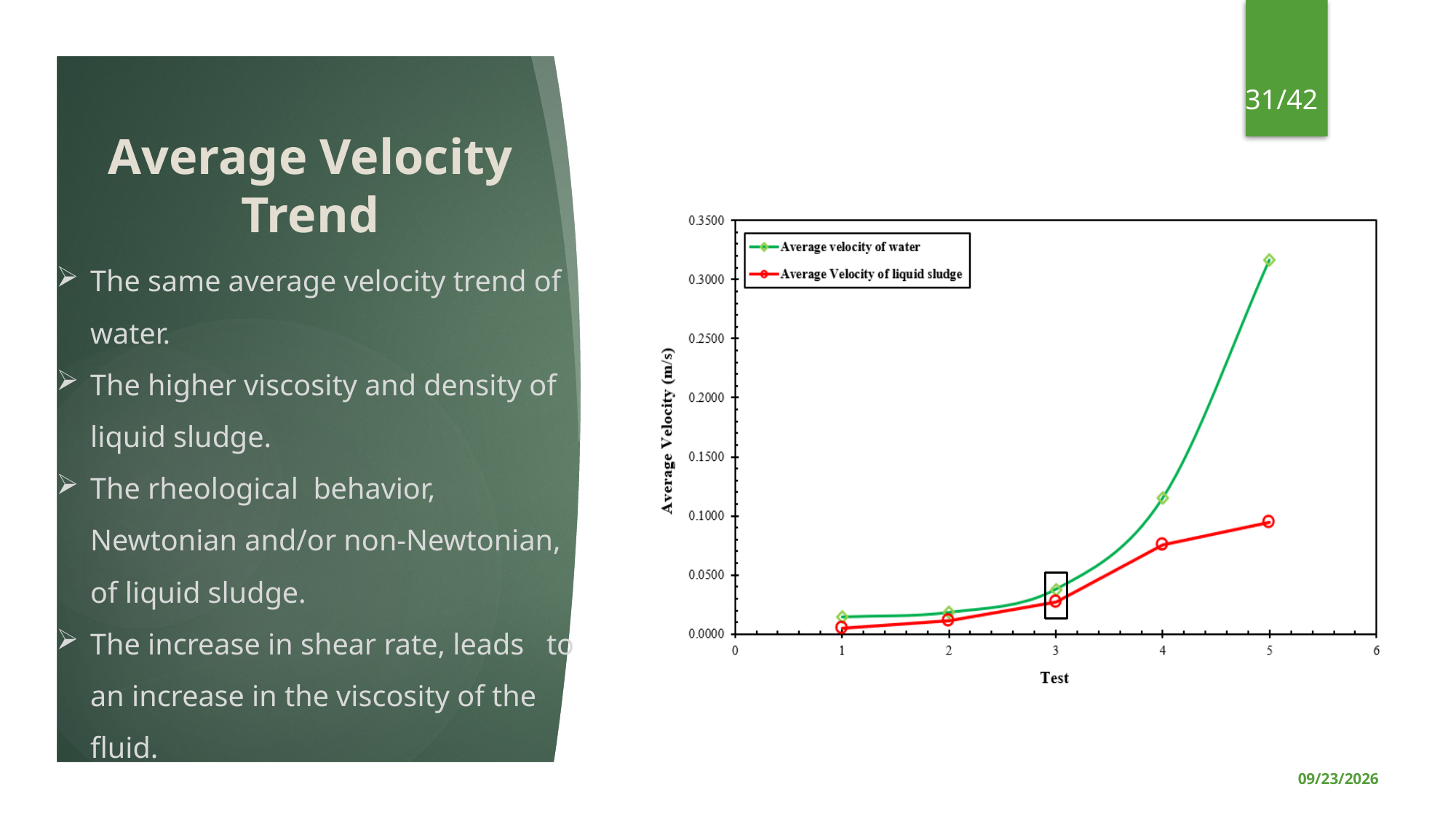
Is the average velocity of liquid sludge at test 4 greater or less than 0.1000 m/s? less Which colour is used for the average velocity of liquid sludge series? Red Is the average velocity of water at test 5 greater or less than 0.3000 m/s? greater What is the label of the y axis? Average Velocity (m/s) At which test is the average velocity of liquid sludge lowest? Test 1 Which series has the larger value at test 5, average velocity of water or average velocity of liquid sludge? Average velocity of water At which test is the average velocity of water highest? Test 5 How many test points are plotted for each series? 5 Is the average velocity of water at test 3 greater or less than 0.0500 m/s? less Do the average velocity values rise or fall as the test number increases? Rise How many series does the legend list? 2 What kind of chart is shown on the slide? Line chart